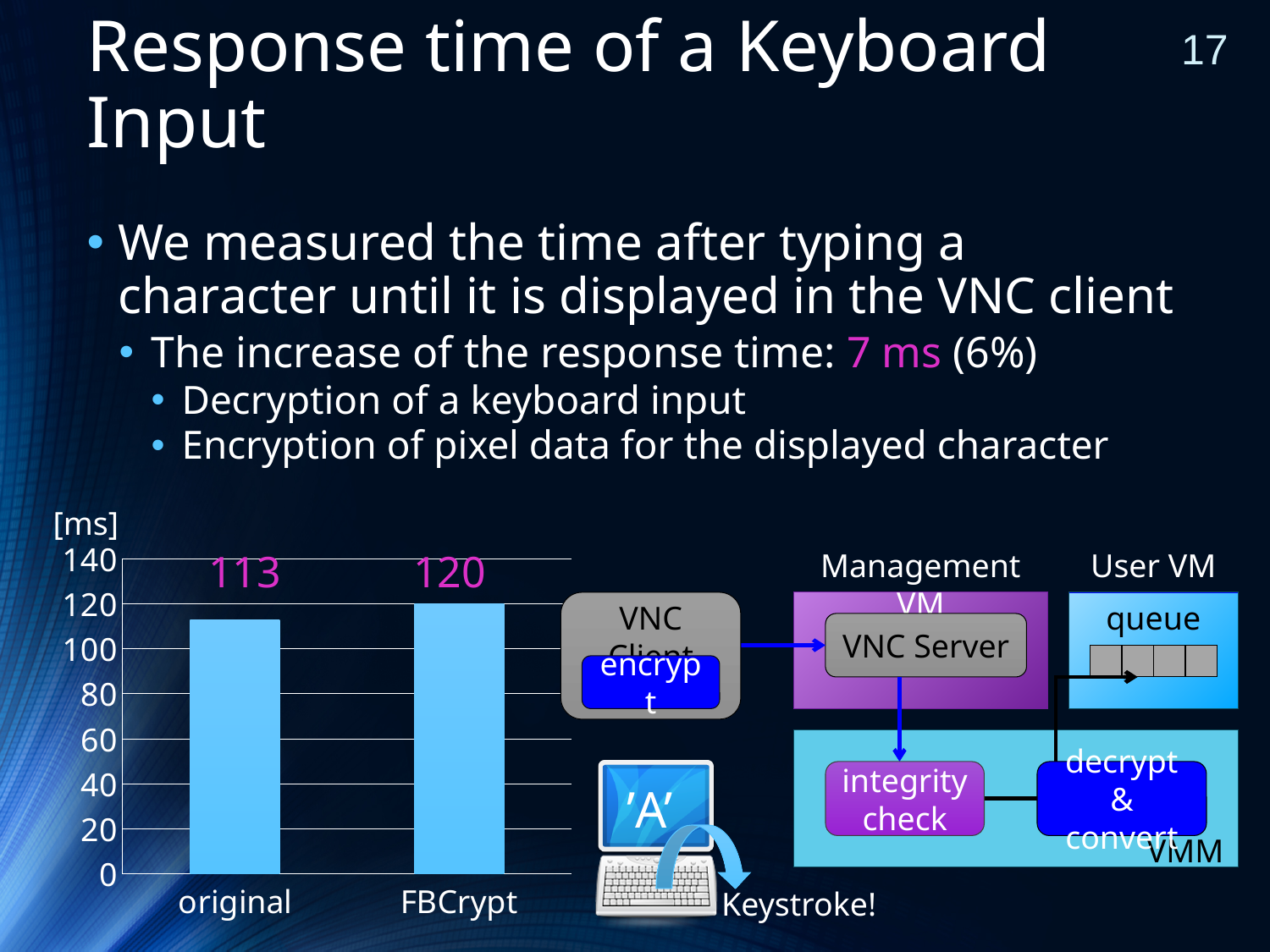
How many categories are shown in the chart? 2 What is the difference in response time between FBCrypt and original? 7 Is the value for original greater or less than 100? greater What kind of chart is shown on the slide? bar chart Which category has the lower response time? original Is the value for FBCrypt greater or less than 140? less What unit is shown on the y axis of the chart? [ms] What is the response time for FBCrypt? 120 Which category has the higher response time? FBCrypt What is the maximum value shown on the y axis? 140 Is the value for original larger or smaller than the value for FBCrypt? smaller What is the response time for original? 113